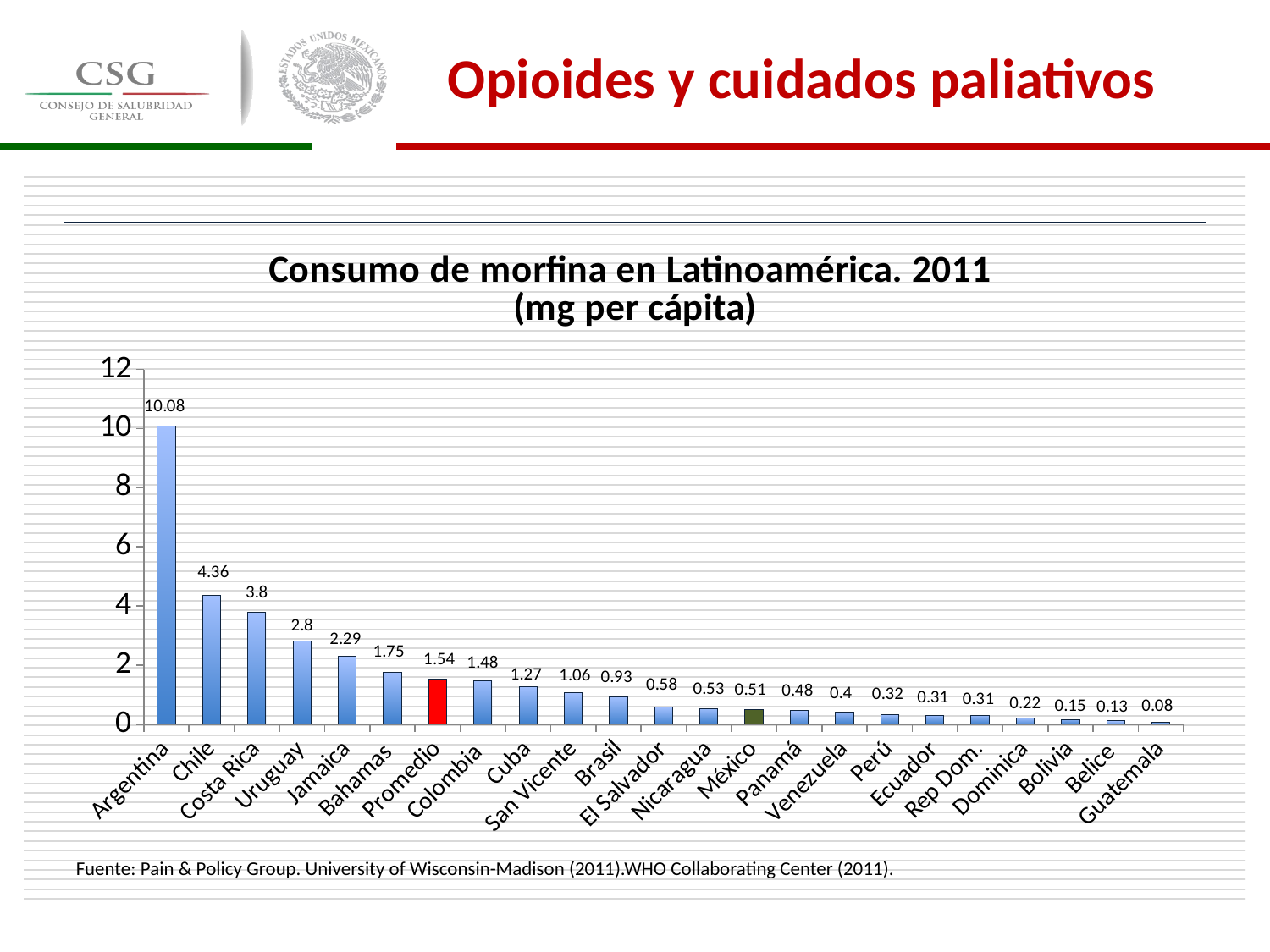
What is the difference between the values for Argentina and Chile? 5.72 How many categories are shown on the x axis of the chart? 23 What kind of chart is shown on the slide? Bar chart Which country has the highest morphine consumption in the chart? Argentina What value is shown for Guatemala? 0.08 What value is shown for México? 0.51 What is the difference between the values for Promedio and México? 1.03 Which has a higher value, Costa Rica or Uruguay? Costa Rica Which country has the lowest morphine consumption in the chart? Guatemala What value is shown for Promedio? 1.54 Do the values rise or fall from left to right along the x axis? Fall What is the morphine consumption value shown for Argentina? 10.08